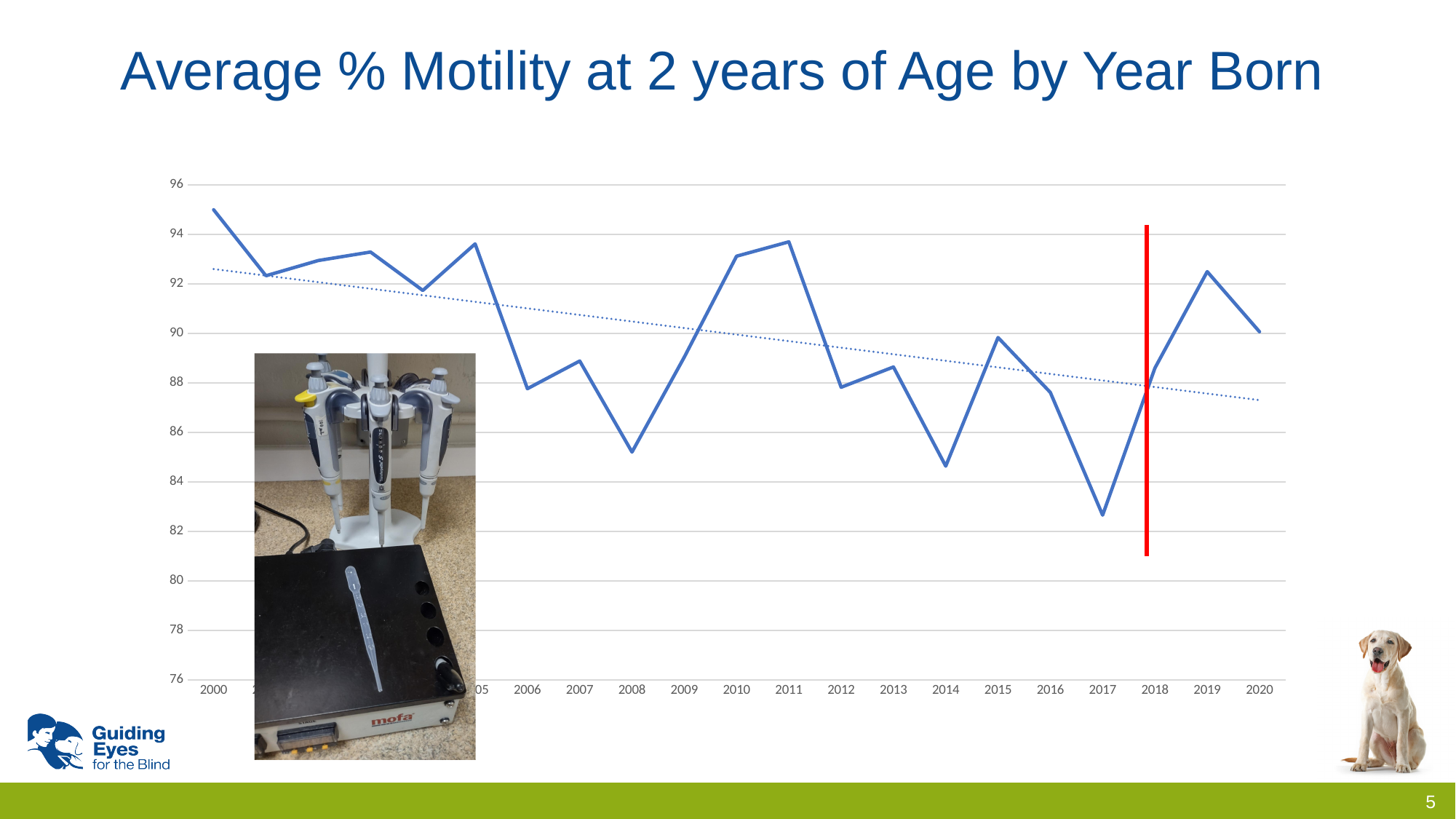
What kind of chart is shown on the slide? line chart Is the value for 2019 greater or less than 92? greater Does the dotted trend line rise or fall from 2000 to 2020? fall Is the value for 2000 greater or less than 94? greater Which year has the lowest average % motility? 2017 Which year has the highest average % motility? 2000 What is the title of the chart? Average % Motility at 2 years of Age by Year Born Which year has the larger value, 2015 or 2016? 2015 Is the value for 2017 greater or less than 84? less Which year has the larger value, 2011 or 2012? 2011